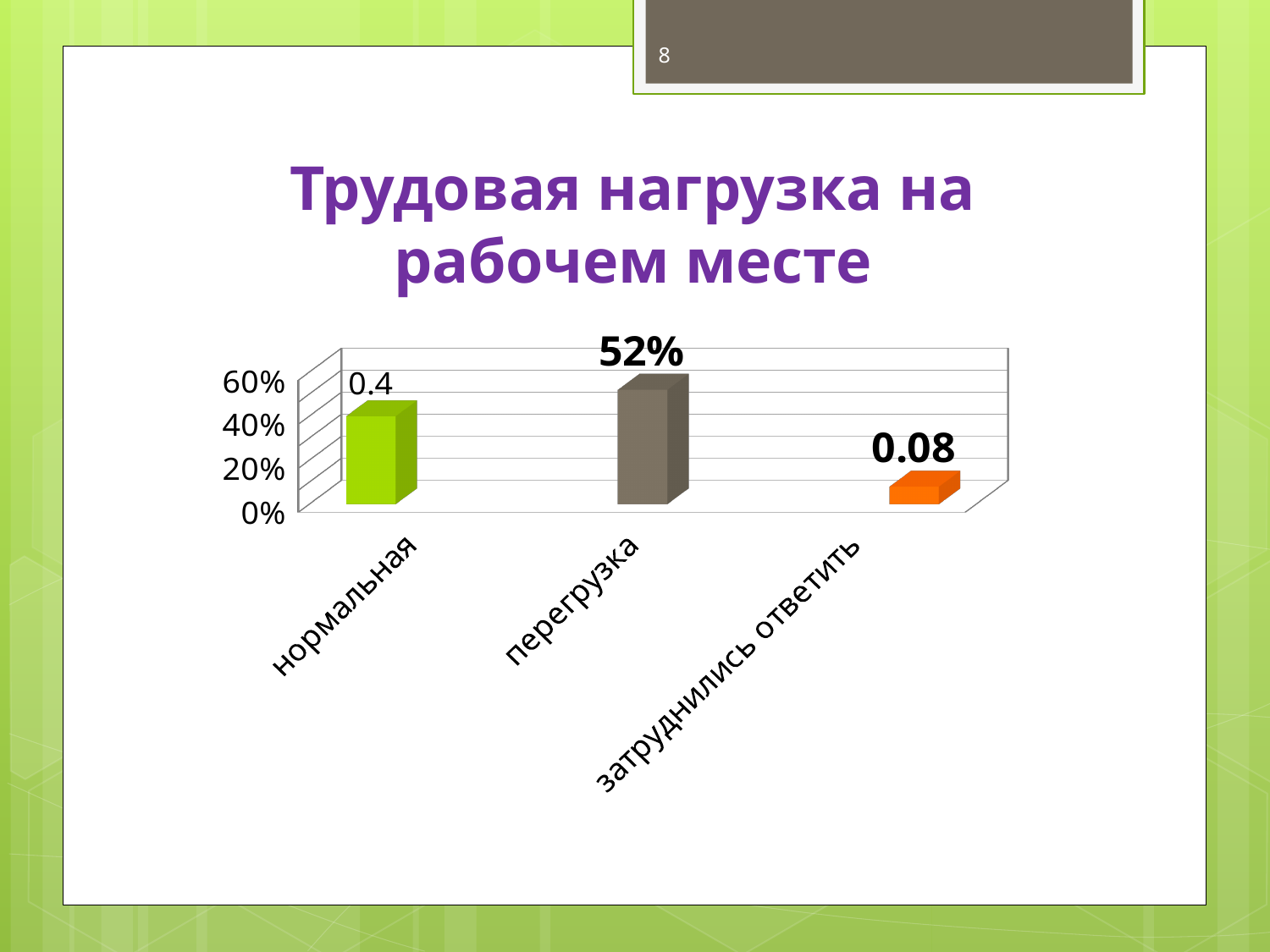
What value is shown for the category "затруднились ответить"? 0.08 Which category has the highest value? перегрузка How many categories are shown on the chart? 3 Which category has the lowest value? затруднились ответить What value is shown for the category "нормальная"? 0.4 Which is larger, the value for "нормальная" or the value for "затруднились ответить"? нормальная Is the value for "перегрузка" greater or less than 40%? greater What is the difference between the values for "нормальная" and "затруднились ответить"? 0.32 What kind of chart is shown on the slide? bar chart What value is shown for the category "перегрузка"? 52% Is the value for "затруднились ответить" greater or less than 20%? less What is the title of the slide containing the chart? Трудовая нагрузка на рабочем месте